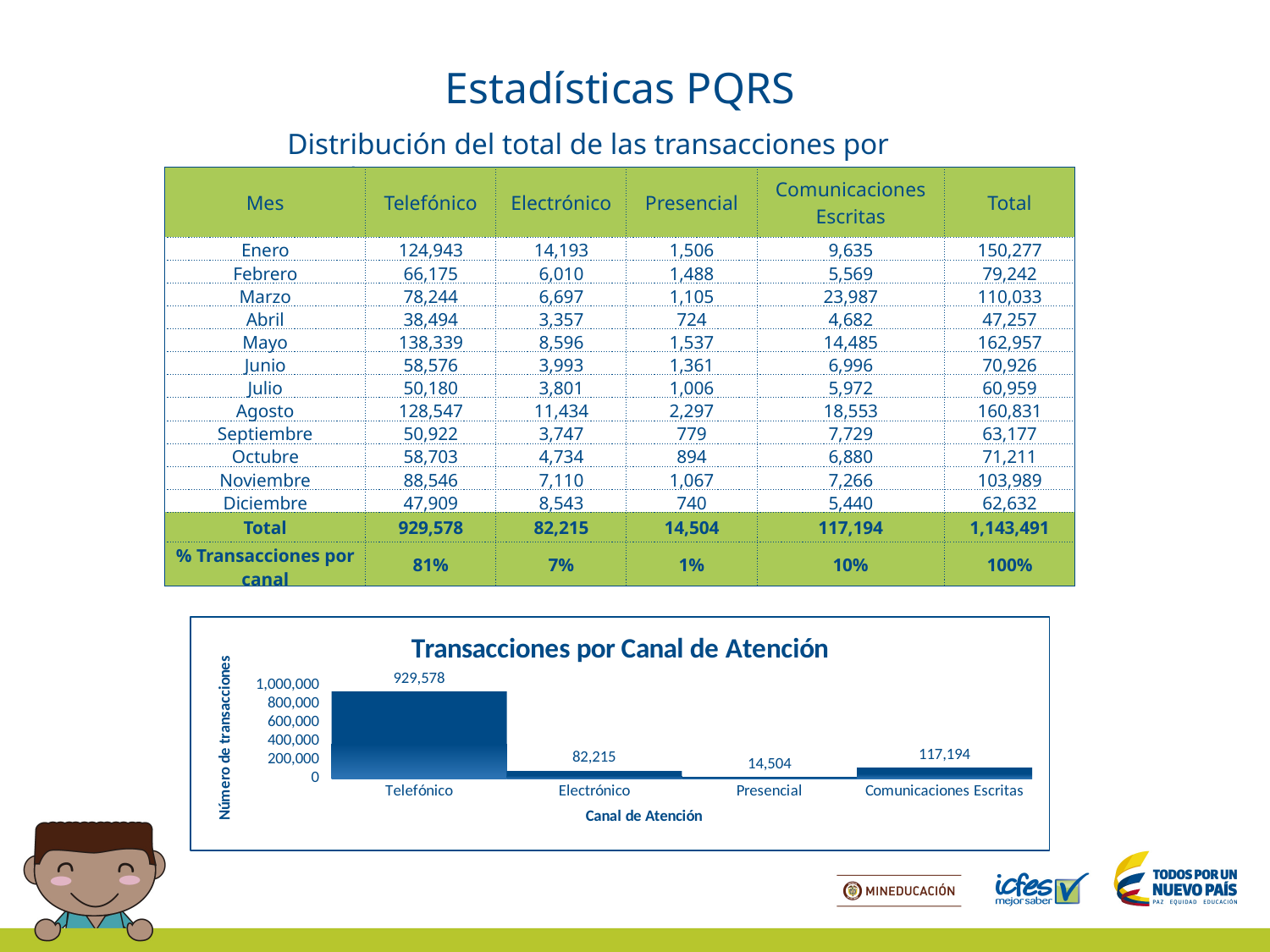
In the chart, what is the value for Presencial? 14,504 What is the title of the chart? Transacciones por Canal de Atención What type of chart is shown on the slide? bar chart In the chart, what is the value for Comunicaciones Escritas? 117,194 In the chart, which is larger: Electrónico or Comunicaciones Escritas? Comunicaciones Escritas What is the label of the y axis of the chart? Número de transacciones Which channel has the highest number of transactions in the chart? Telefónico How many channels (categories) are shown on the x axis of the chart? 4 What is the difference between the values for Telefónico and Comunicaciones Escritas in the chart? 812,384 In the chart, what is the value for Telefónico? 929,578 In the chart, what is the value for Electrónico? 82,215 Which channel has the lowest number of transactions in the chart? Presencial